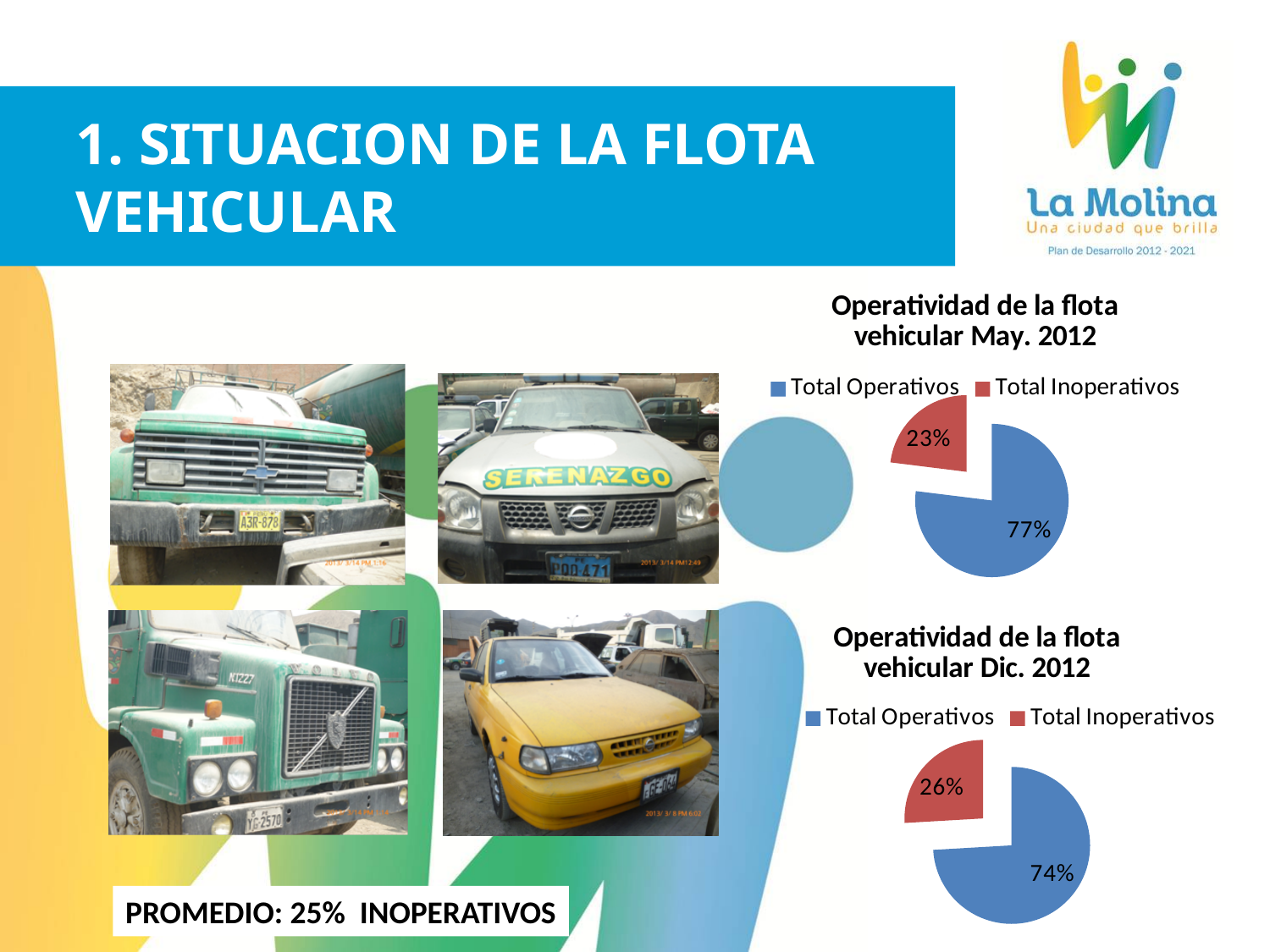
How many slices does the 'Operatividad de la flota vehicular Dic. 2012' pie chart have? 2 Which is larger: Total Inoperativos in the May. 2012 chart or Total Inoperativos in the Dic. 2012 chart? Dic. 2012 In the 'Operatividad de la flota vehicular Dic. 2012' chart, what colour is the Total Inoperativos slice? Red In the 'Operatividad de la flota vehicular May. 2012' chart, what share is Total Operativos? 77% What kind of chart is 'Operatividad de la flota vehicular May. 2012'? Pie chart In the 'Operatividad de la flota vehicular Dic. 2012' chart, what share is Total Operativos? 74% In the 'Operatividad de la flota vehicular May. 2012' chart, what share is Total Inoperativos? 23% In the 'Operatividad de la flota vehicular Dic. 2012' chart, which category has the largest slice? Total Operativos In the 'Operatividad de la flota vehicular May. 2012' chart, which category has the smallest slice? Total Inoperativos In the 'Operatividad de la flota vehicular Dic. 2012' chart, what share is Total Inoperativos? 26% How many entries does the legend of the 'Operatividad de la flota vehicular May. 2012' chart list? 2 In the 'Operatividad de la flota vehicular May. 2012' chart, what is the difference between Total Operativos and Total Inoperativos? 54%